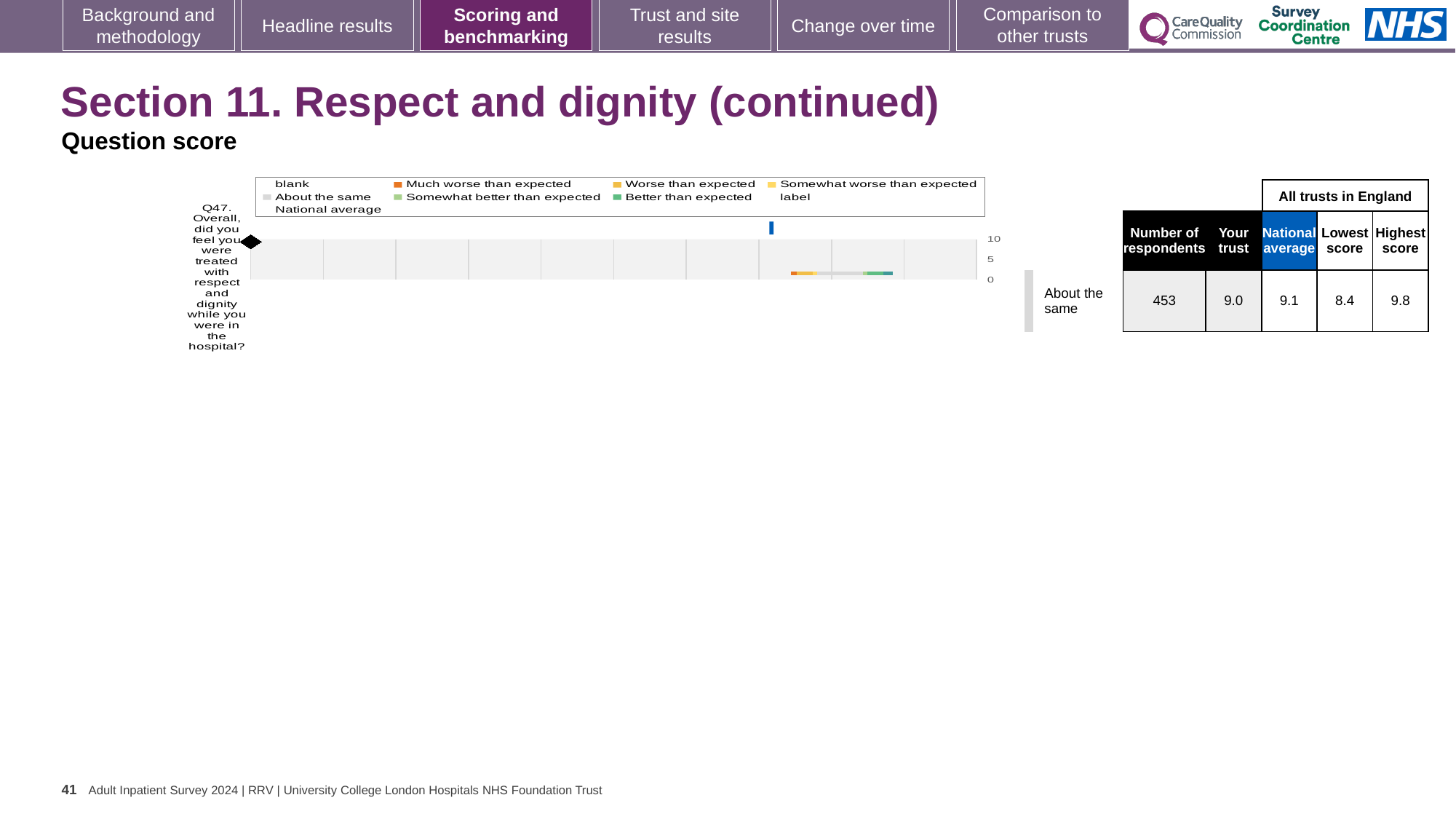
In the table beside the chart, what is the difference between the Highest score and the Lowest score for Q47? 1.4 What is the highest tick value shown on the chart's axis? 10 What colour does the legend use for 'Much worse than expected'? orange In the table beside the chart, what is the 'Your trust' score for Q47? 9.0 What kind of chart is shown on the slide? bar chart In the table beside the chart, what is the Highest score among all trusts in England for Q47? 9.8 In the table beside the chart, which is larger for Q47: the 'Your trust' score or the National average? National average In the table beside the chart, what is the number of respondents for Q47? 453 In the table beside the chart, what is the National average for Q47? 9.1 How many entries does the chart's legend list? 9 In the table beside the chart, what is the Lowest score among all trusts in England for Q47? 8.4 How many questions (categories) are plotted in the chart? 1